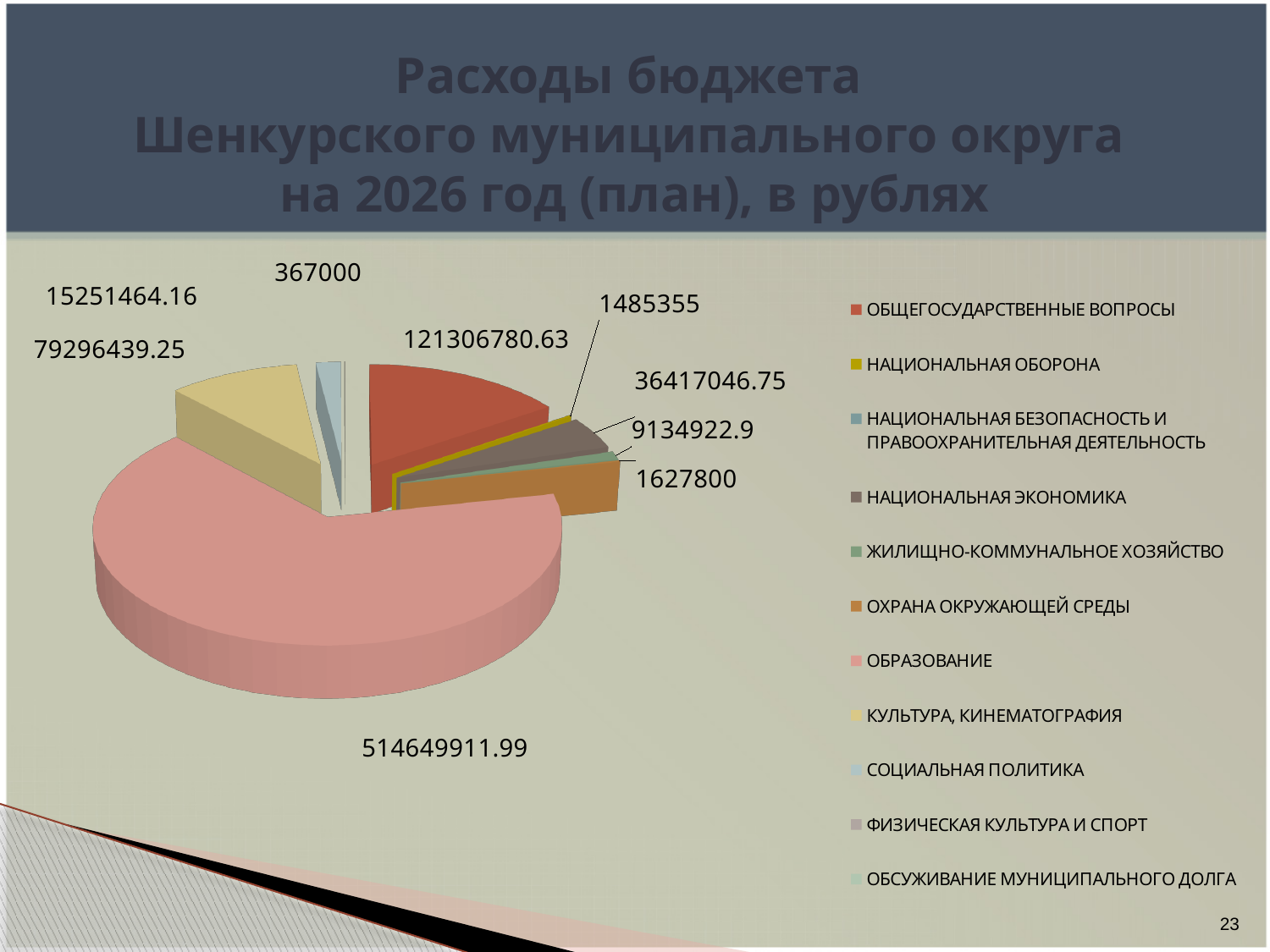
How many categories are listed in the legend? 11 Which category has the largest slice of the pie? ОБРАЗОВАНИЕ Which is larger, the value for ОБРАЗОВАНИЕ or the value for КУЛЬТУРА, КИНЕМАТОГРАФИЯ? ОБРАЗОВАНИЕ What is the value shown for ОБРАЗОВАНИЕ? 514649911.99 What is the value shown for ФИЗИЧЕСКАЯ КУЛЬТУРА И СПОРТ? 367000 What is the value shown for КУЛЬТУРА, КИНЕМАТОГРАФИЯ? 79296439.25 What is the value shown for ОБЩЕГОСУДАРСТВЕННЫЕ ВОПРОСЫ? 121306780.63 What year does the chart title say the budget expenditure plan is for? 2026 Which is larger, the value for ОБЩЕГОСУДАРСТВЕННЫЕ ВОПРОСЫ or the value for СОЦИАЛЬНАЯ ПОЛИТИКА? ОБЩЕГОСУДАРСТВЕННЫЕ ВОПРОСЫ What kind of chart is shown on the slide? pie chart What is the difference between the value for ОБРАЗОВАНИЕ and the value for ОБЩЕГОСУДАРСТВЕННЫЕ ВОПРОСЫ? 393343131.36 What is the value shown for СОЦИАЛЬНАЯ ПОЛИТИКА? 15251464.16